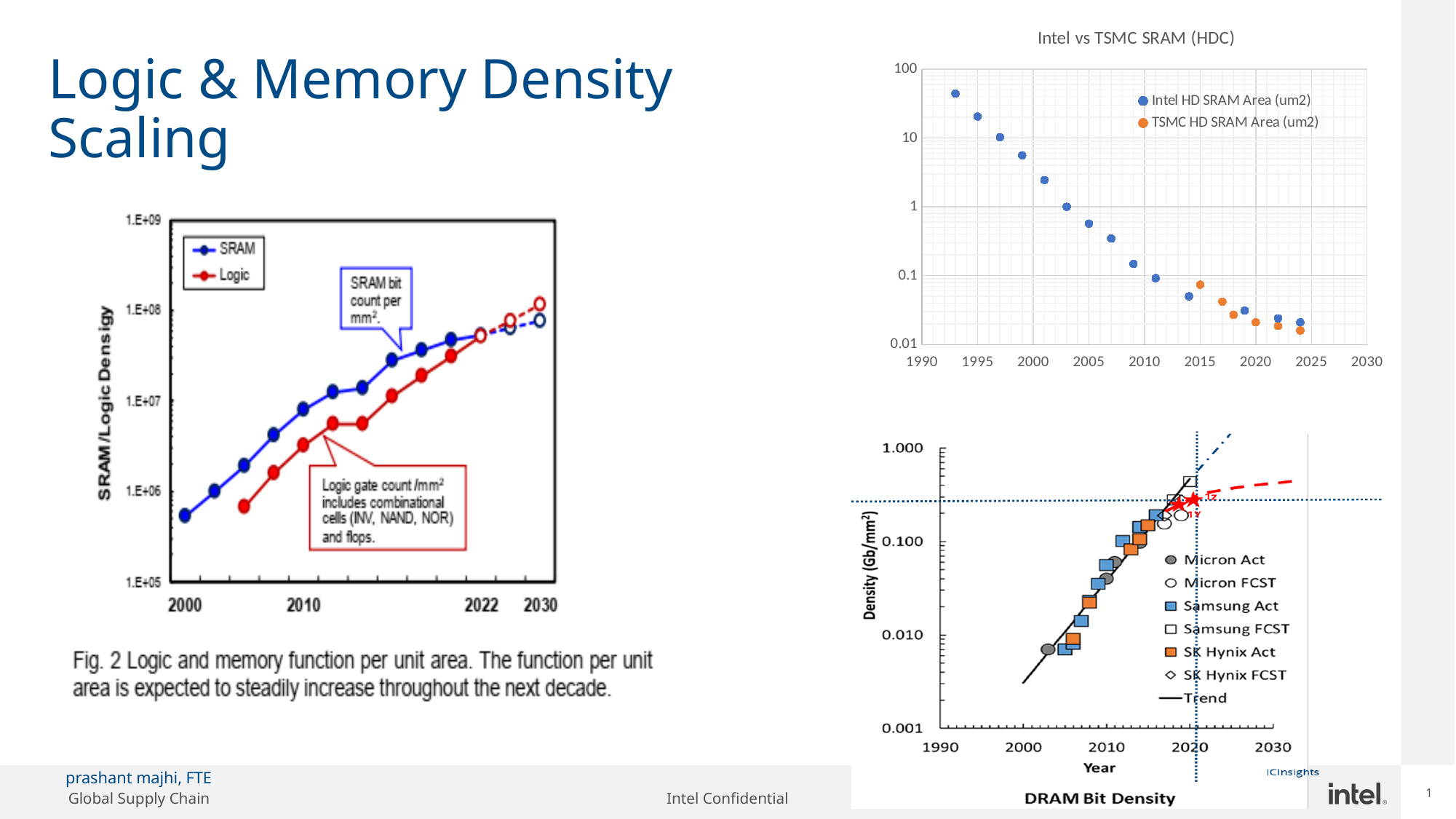
In the bottom-right chart titled "DRAM Bit Density", do the plotted density values rise or fall as the year increases? rise In the top-right chart titled "Intel vs TSMC SRAM (HDC)", do the Intel HD SRAM Area values rise or fall as the year increases? fall In the bottom-right chart titled "DRAM Bit Density", what is the label of the y axis? Density (Gb/mm²) In the left chart (Fig. 2, SRAM/Logic Density), is the SRAM value at 2000 greater or less than 1.E+06? less In the bottom-right chart titled "DRAM Bit Density", how many entries does the legend list? 7 In the top-right chart titled "Intel vs TSMC SRAM (HDC)", is the TSMC HD SRAM Area value at 2024 greater or less than 0.1? less In the left chart (Fig. 2, SRAM/Logic Density), which series is higher at 2010, SRAM or Logic? SRAM In the top-right chart titled "Intel vs TSMC SRAM (HDC)", how many series does the legend list? 2 In the left chart (Fig. 2, SRAM/Logic Density), how many series does the legend list? 2 In the top-right chart titled "Intel vs TSMC SRAM (HDC)", what kind of chart is it? scatter chart In the left chart (Fig. 2, SRAM/Logic Density), do the SRAM values rise or fall from 2000 to 2030? rise In the top-right chart titled "Intel vs TSMC SRAM (HDC)", is the earliest Intel HD SRAM Area value (around 1993) greater or less than 10? greater